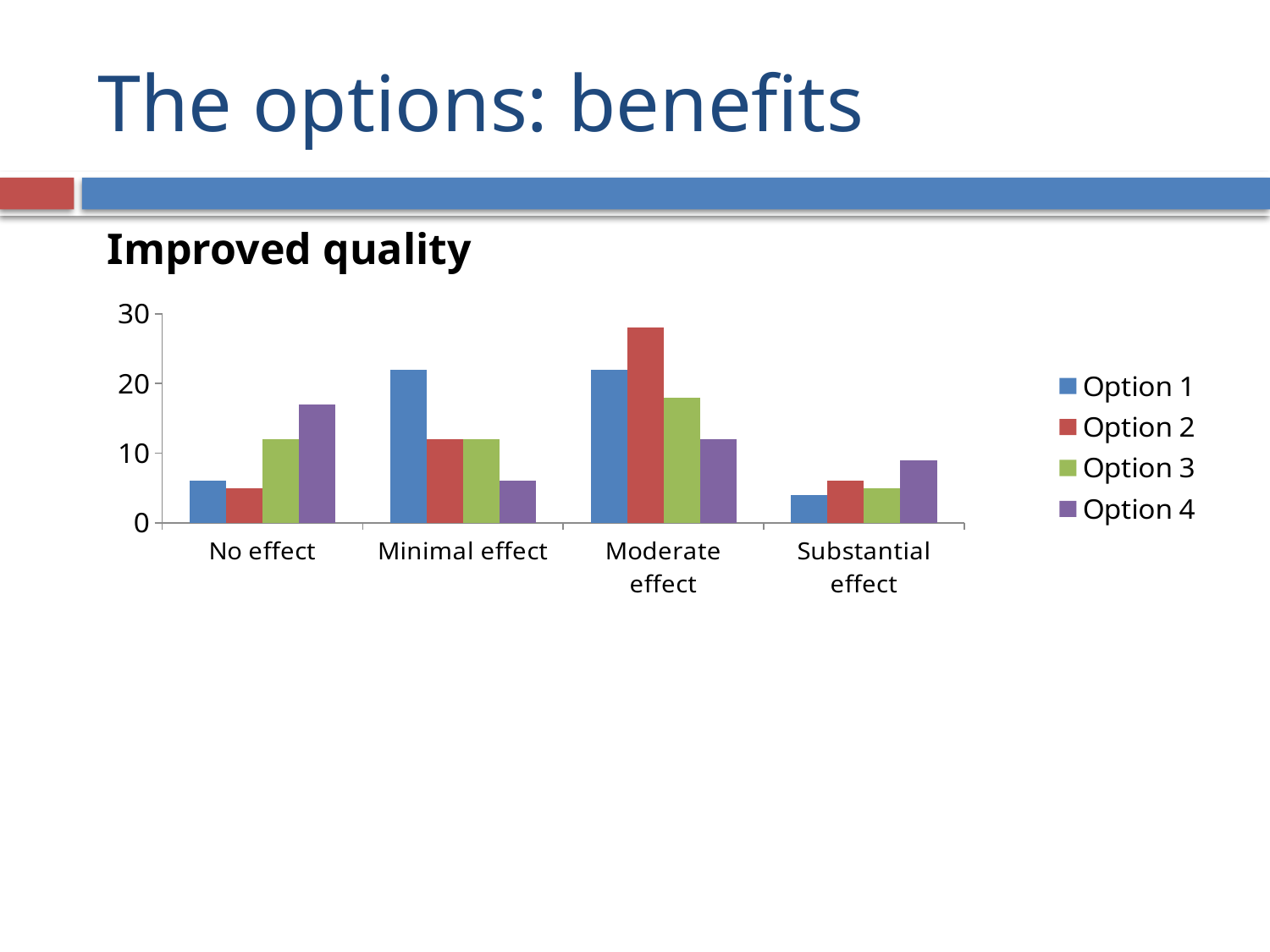
Which option has the highest bar in the Minimal effect category? Option 1 Is the value for Option 4 in the Minimal effect category greater or less than 10? less In the Moderate effect category, which is larger: Option 1 or Option 2? Option 2 Is the value for Option 1 in the Minimal effect category greater or less than 20? greater What kind of chart is shown on the slide? bar chart How many categories are shown on the x axis? 4 Which option has the lowest bar in the Minimal effect category? Option 4 What is the title of the chart? Improved quality Which option has the highest bar in the Moderate effect category? Option 2 How many series does the legend list? 4 Which option has the lowest bar in the Moderate effect category? Option 4 Which option has the highest bar in the No effect category? Option 4